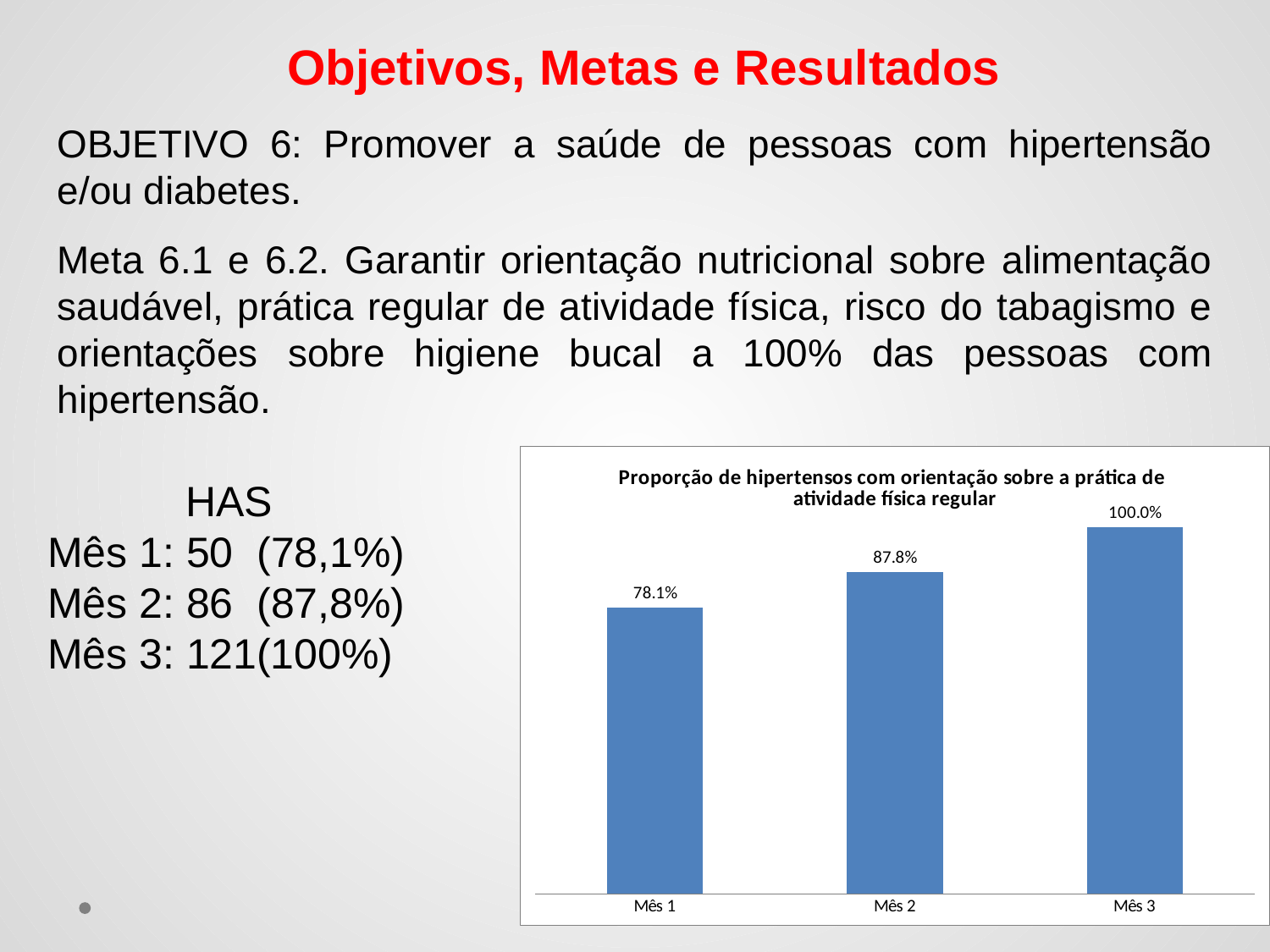
What is the value for Mês 1 in the chart? 78.1% How many months are shown on the x axis of the chart? 3 Which month has the highest value in the chart? Mês 3 What is the title of the chart? Proporção de hipertensos com orientação sobre a prática de atividade física regular What is the value for Mês 2 in the chart? 87.8% Do the values rise or fall from Mês 1 to Mês 3? Rise Which is larger, the value for Mês 2 or the value for Mês 1? Mês 2 What is the value for Mês 3 in the chart? 100.0% What is the difference between the values for Mês 3 and Mês 1? 21.9% What is the difference between the values for Mês 2 and Mês 1? 9.7% Which month has the lowest value in the chart? Mês 1 What kind of chart is shown on the slide? Bar chart